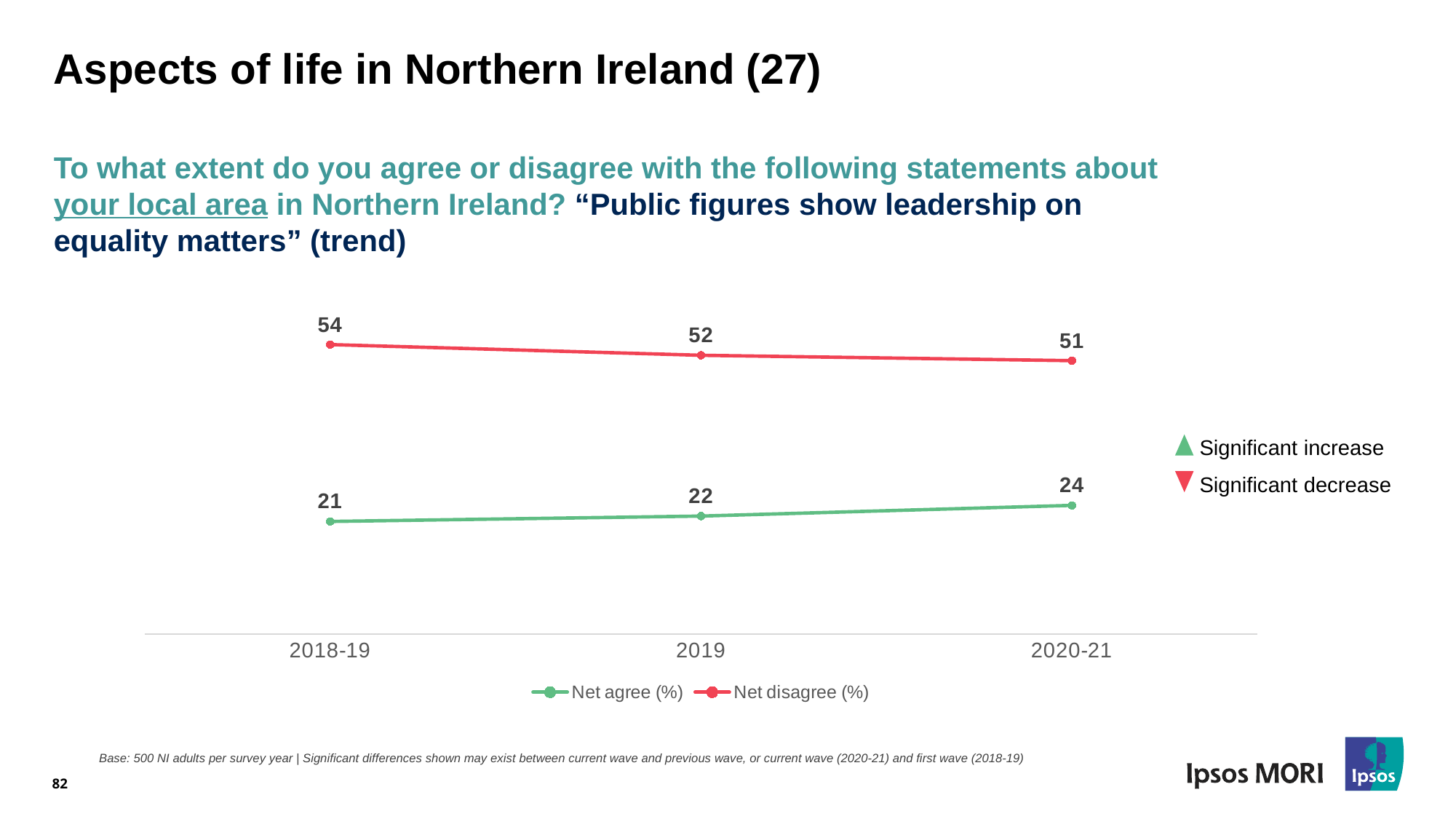
By how much did Net disagree (%) change from 2018-19 to 2020-21? 3 In which year is Net agree (%) lowest? 2018-19 What is the Net disagree (%) value for 2020-21? 51 What is the Net agree (%) value for 2019? 22 What kind of chart is shown on the slide? Line chart How many series does the chart legend list? 2 What is the difference between Net disagree (%) and Net agree (%) in 2020-21? 27 What is the Net agree (%) value for 2018-19? 21 How many survey years are shown on the x axis? 3 Which is larger in 2019, Net agree (%) or Net disagree (%)? Net disagree (%) Does Net agree (%) rise or fall from 2018-19 to 2020-21? Rise In which year is Net disagree (%) highest? 2018-19